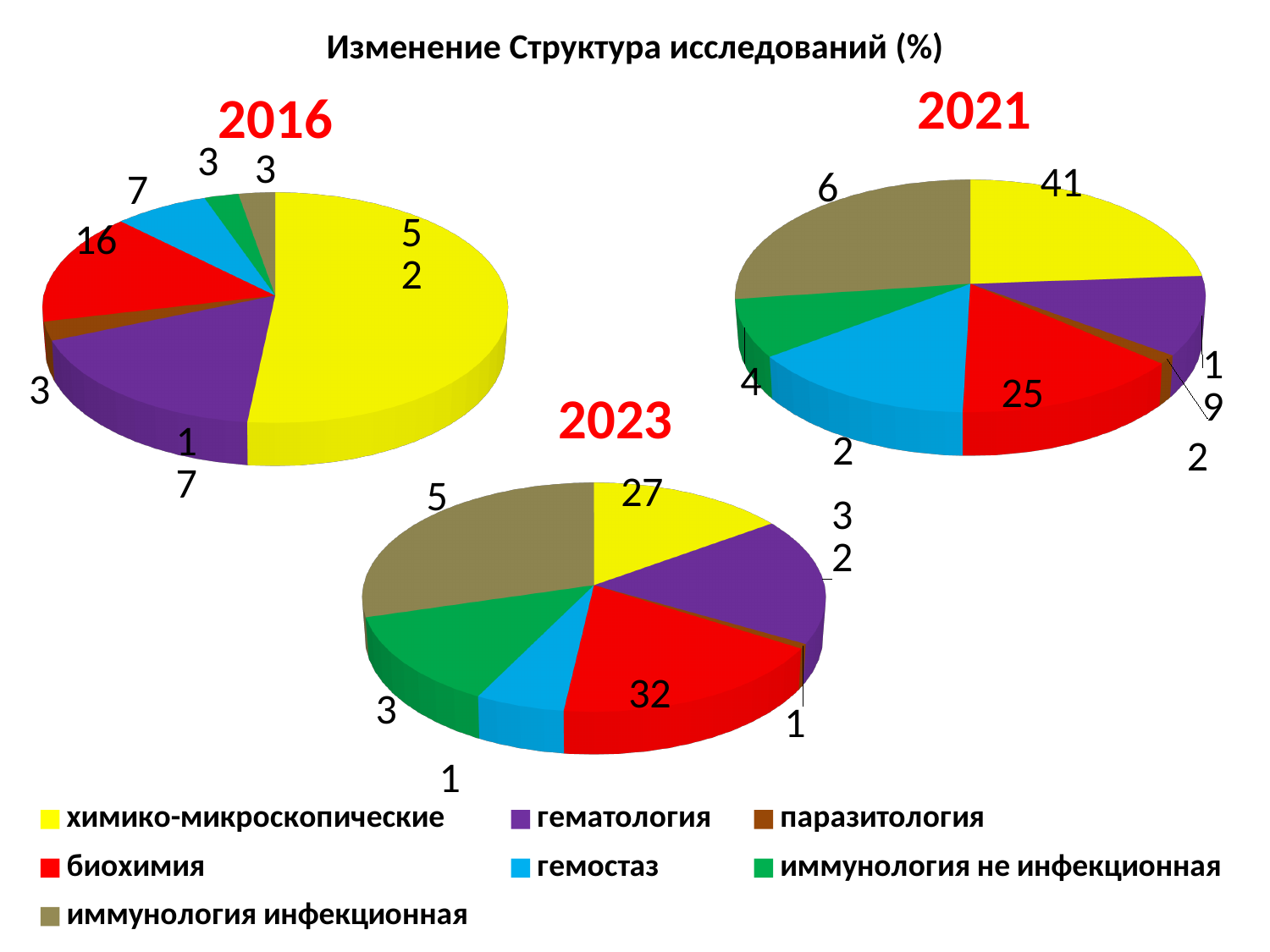
In the 2021 pie chart, what is the value for иммунология инфекционная? 6 How many categories does the legend list? 7 In the 2016 pie chart, what is the value for биохимия? 16 What kind of charts are shown on the slide? Pie charts In the 2023 pie chart, what is the value for биохимия? 32 In the 2016 pie chart, what is the value for гемостаз? 7 In the 2023 pie chart, which is larger, биохимия or химико-микроскопические? биохимия In the 2021 pie chart, what is the difference between химико-микроскопические and биохимия? 16 In the 2016 pie chart, which category has the largest share? химико-микроскопические In the 2021 pie chart, what is the value for химико-микроскопические? 41 How many pie charts are on the slide? 3 In the 2021 pie chart, what is the value for биохимия? 25